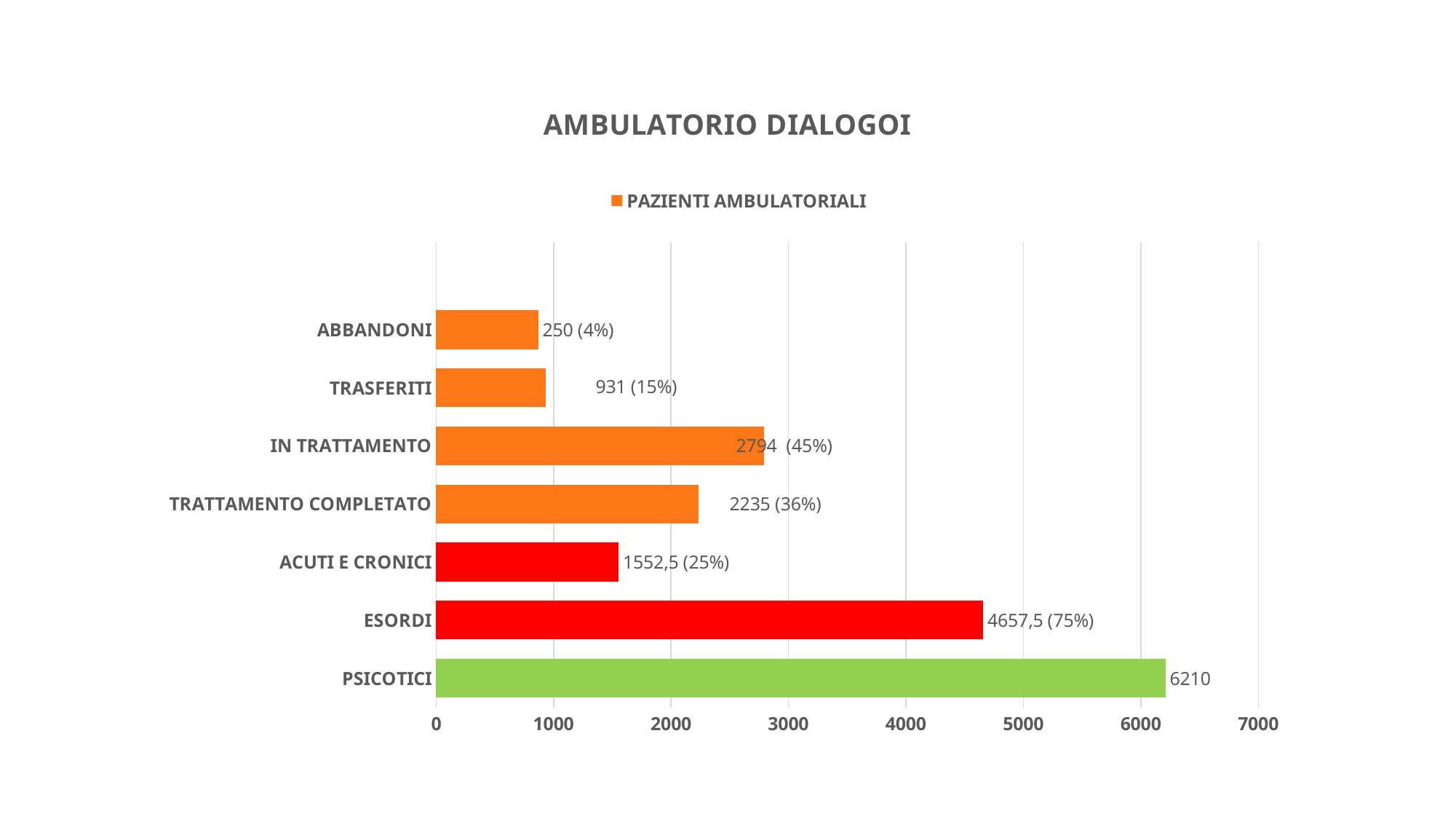
What value is shown for PSICOTICI? 6210 What percentage is shown next to the ESORDI bar? 75% Which category has the highest value? PSICOTICI Is the value for ESORDI greater or less than 4000? greater What is the data label shown for ABBANDONI? 250 (4%) What is the title of the chart? AMBULATORIO DIALOGOI Which category has the lowest value? ABBANDONI What type of chart is shown on the slide? bar chart Which is larger, the value for TRASFERITI or the value for ABBANDONI? TRASFERITI What is the difference between the values for IN TRATTAMENTO (2794) and TRATTAMENTO COMPLETATO (2235)? 559 What is the data label shown for ACUTI E CRONICI? 1552,5 (25%) How many categories are shown on the chart? 7